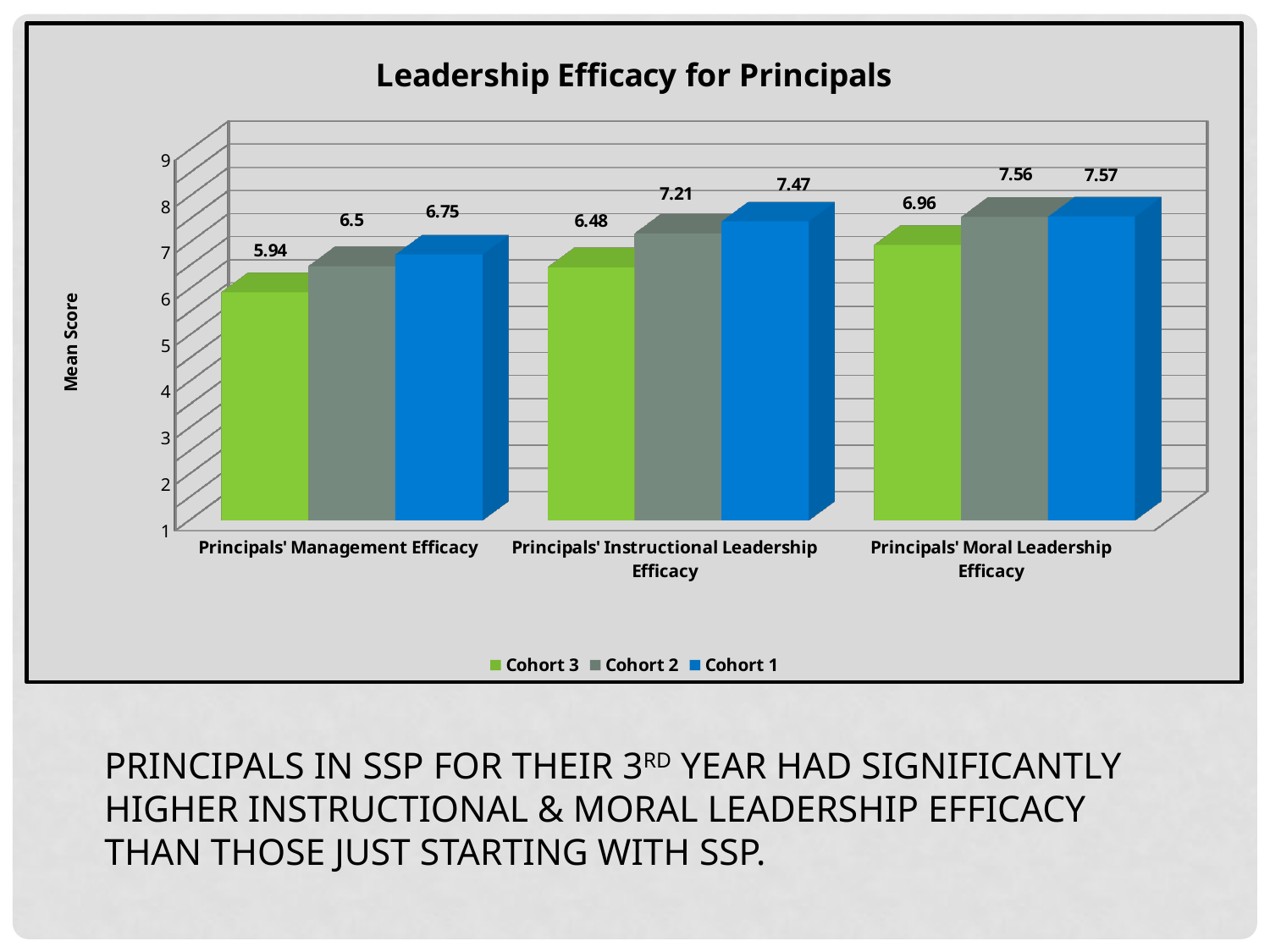
What is the Cohort 1 value for Principals' Instructional Leadership Efficacy? 7.47 How many categories are shown on the x axis? 3 Which is larger: the Cohort 2 value for Principals' Instructional Leadership Efficacy or the Cohort 3 value for Principals' Moral Leadership Efficacy? Cohort 2 value for Principals' Instructional Leadership Efficacy What kind of chart is shown on the slide? Bar chart What is the Cohort 3 value for Principals' Management Efficacy? 5.94 What is the title of the chart? Leadership Efficacy for Principals Which category has the lowest Cohort 3 value? Principals' Management Efficacy How many series does the legend list? 3 Which category has the highest Cohort 1 value? Principals' Moral Leadership Efficacy What is the difference between the Cohort 1 and Cohort 3 values for Principals' Instructional Leadership Efficacy? 0.99 What is the difference between the Cohort 2 and Cohort 3 values for Principals' Management Efficacy? 0.56 What is the Cohort 2 value for Principals' Moral Leadership Efficacy? 7.56